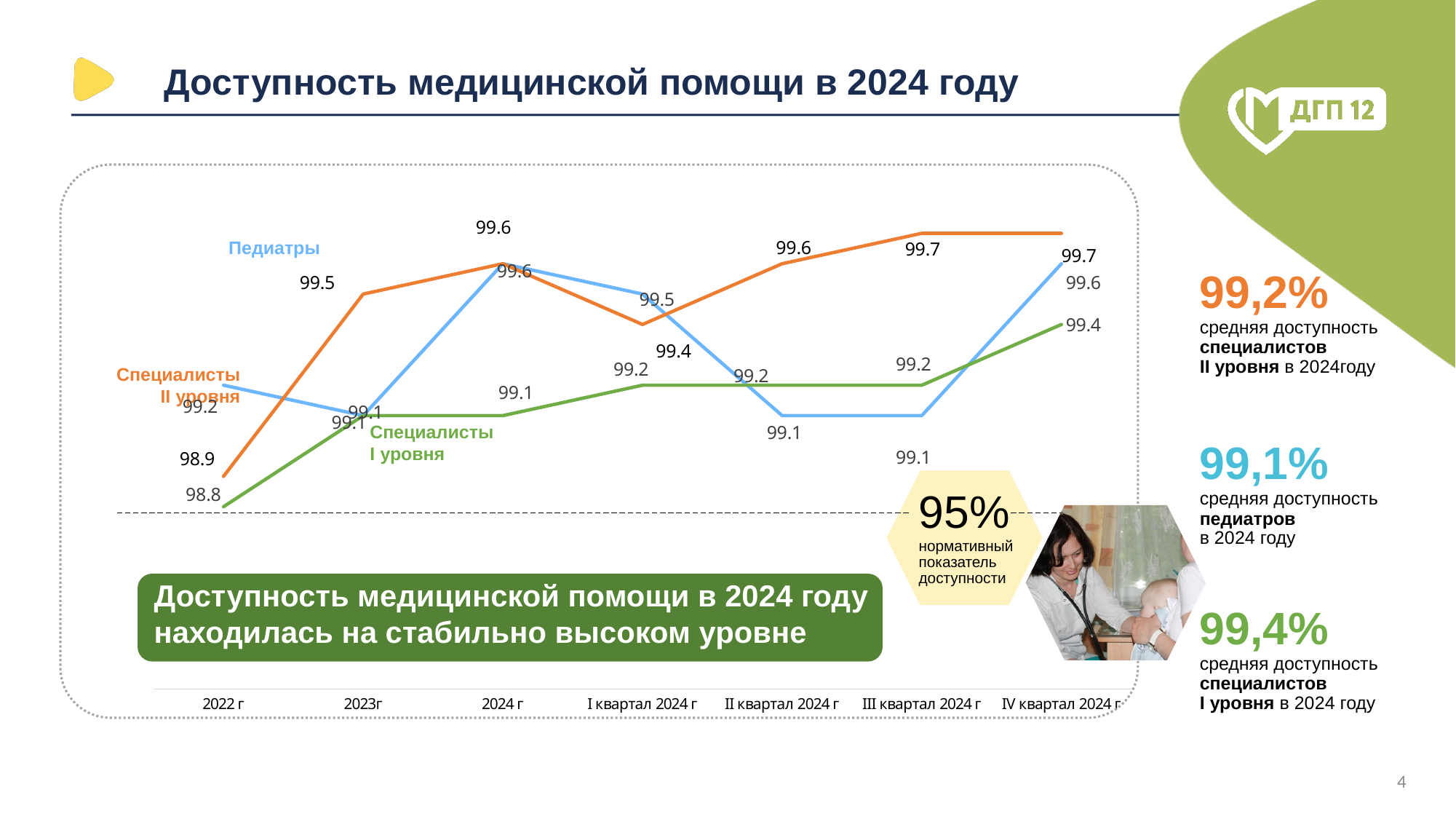
What is the value for Специалисты I уровня in 2022 г? 98.8 What is the value for Специалисты II уровня in I квартал 2024 г? 99.4 What is the value for Специалисты I уровня in IV квартал 2024 г? 99.4 At which x-axis point does the Специалисты I уровня series have its lowest value? 2022 г What is the value for Специалисты II уровня in 2023г? 99.5 What is the difference between the Специалисты I уровня values in IV квартал 2024 г and 2022 г? 0.6 What is the value for Специалисты II уровня in 2022 г? 98.9 How many series are plotted on the chart? 3 How many points are there along the x axis of the chart? 7 What type of chart is shown on the slide? Line chart What normative accessibility indicator (нормативный показатель доступности) is shown on the slide? 95% Which series has the highest value in IV квартал 2024 г? Специалисты II уровня